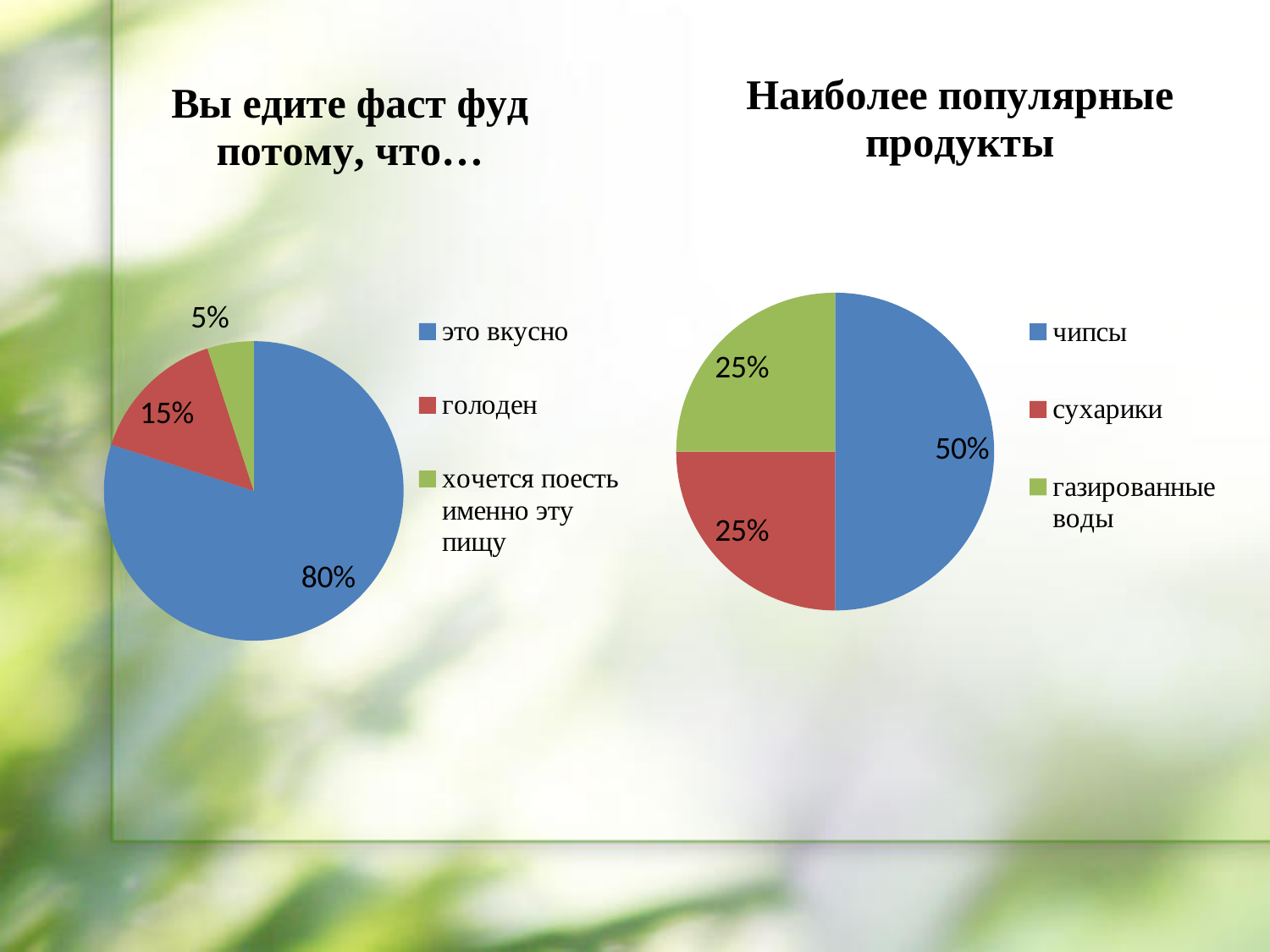
In the right chart 'Наиболее популярные продукты', which category has the largest slice? чипсы In the left chart 'Вы едите фаст фуд потому, что…', what share is labelled for 'голоден'? 15% In the left chart 'Вы едите фаст фуд потому, что…', what share is labelled for 'хочется поесть именно эту пищу'? 5% In the left chart 'Вы едите фаст фуд потому, что…', which category has the smallest slice? хочется поесть именно эту пищу In the left chart 'Вы едите фаст фуд потому, что…', how many slices does the pie have? 3 In the left chart 'Вы едите фаст фуд потому, что…', which category has the largest slice? это вкусно In the right chart 'Наиболее популярные продукты', what share is labelled for 'газированные воды'? 25% In the left chart 'Вы едите фаст фуд потому, что…', what share is labelled for 'это вкусно'? 80% In the left chart 'Вы едите фаст фуд потому, что…', what is the difference between the shares for 'это вкусно' and 'голоден'? 65% In the right chart 'Наиболее популярные продукты', which is larger, the share for 'чипсы' or the share for 'сухарики'? чипсы What kind of chart is the right chart 'Наиболее популярные продукты'? pie chart In the right chart 'Наиболее популярные продукты', what share is labelled for 'чипсы'? 50%